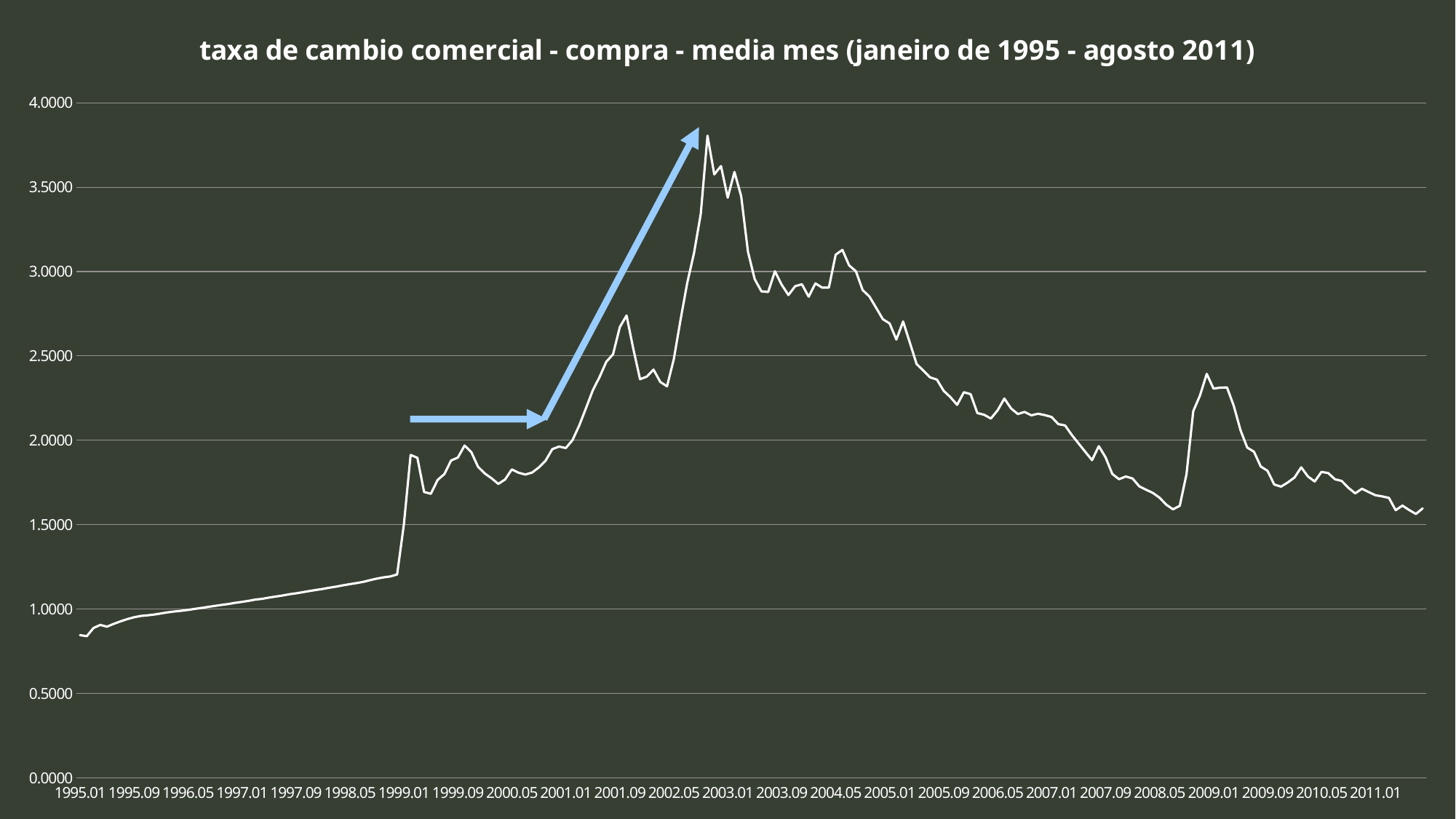
In which year does the line reach its highest point? 2002 What is the title of the chart? taxa de cambio comercial - compra - media mes (janeiro de 1995 - agosto 2011) Is the value at 1999.01 greater or less than 1.0000? greater What colour are the two arrows drawn on the chart? light blue Is the value at 2007.01 greater or less than 2.0000? greater Does the line rise or fall between 1995.01 and 1999.01? rise What kind of chart is shown on the slide? line chart Is the highest point of the line greater or less than 3.5000? greater